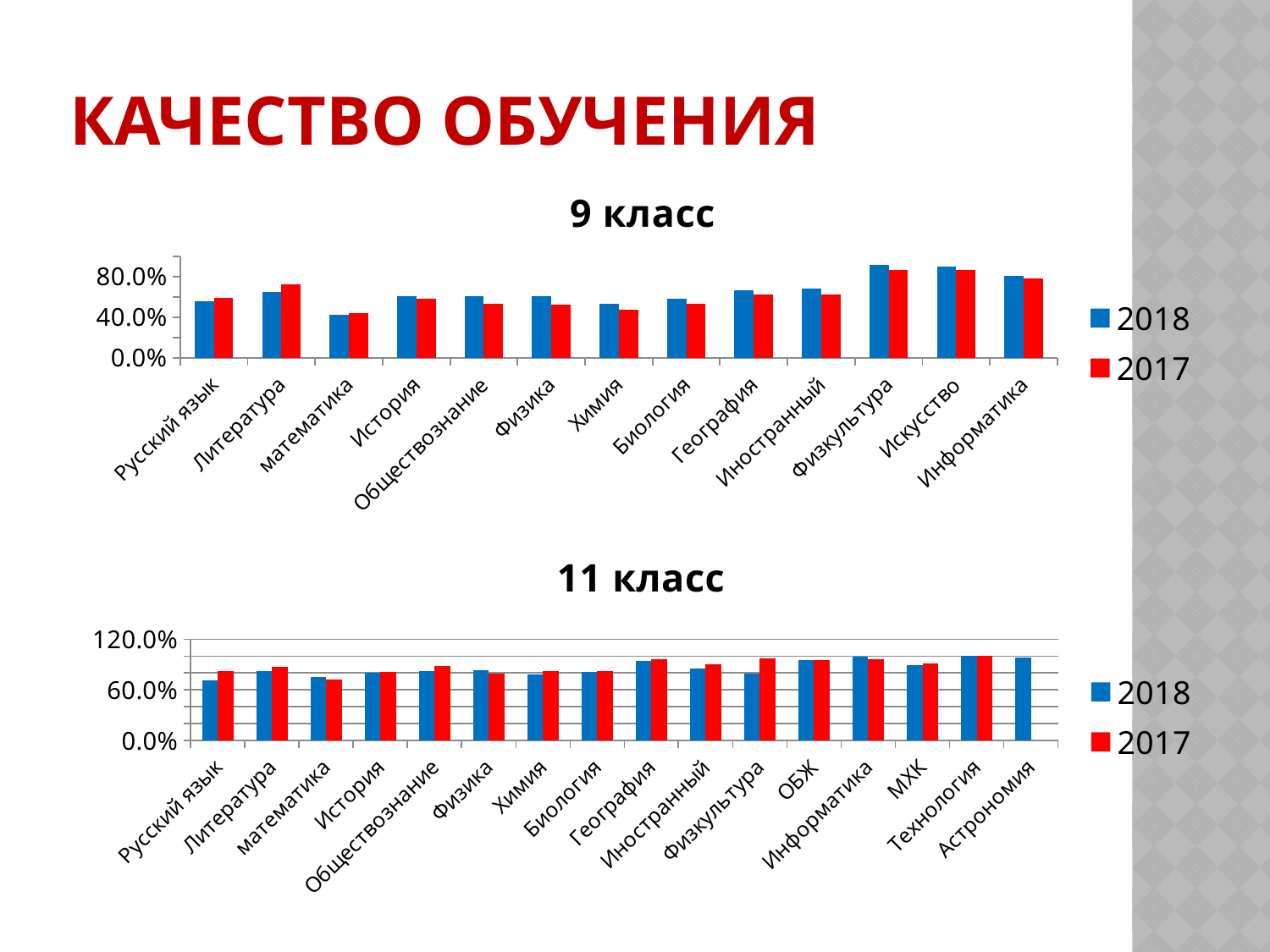
How many subject categories are shown on the x axis of the "11 класс" chart? 16 In the "11 класс" chart, which subject has a bar for 2018 only and no bar for 2017? Астрономия In the "9 класс" chart, is the 2018 value for Физкультура greater or less than 80.0%? greater In the "9 класс" chart, which subject has the lowest value for 2018? математика What kind of chart is the "9 класс" chart? bar chart In the "11 класс" chart, is the 2018 value for Технология greater or less than 60.0%? greater What are the two legend entries of the "11 класс" chart? 2018 and 2017 How many series does the legend of the "9 класс" chart list? 2 How many subject categories are shown on the x axis of the "9 класс" chart? 13 In the "9 класс" chart, which is larger for Литература: the 2018 value or the 2017 value? 2017 In the "11 класс" chart, which is larger for Физкультура: the 2018 value or the 2017 value? 2017 In the "9 класс" chart, is the 2018 value for Русский язык greater or less than 80.0%? less